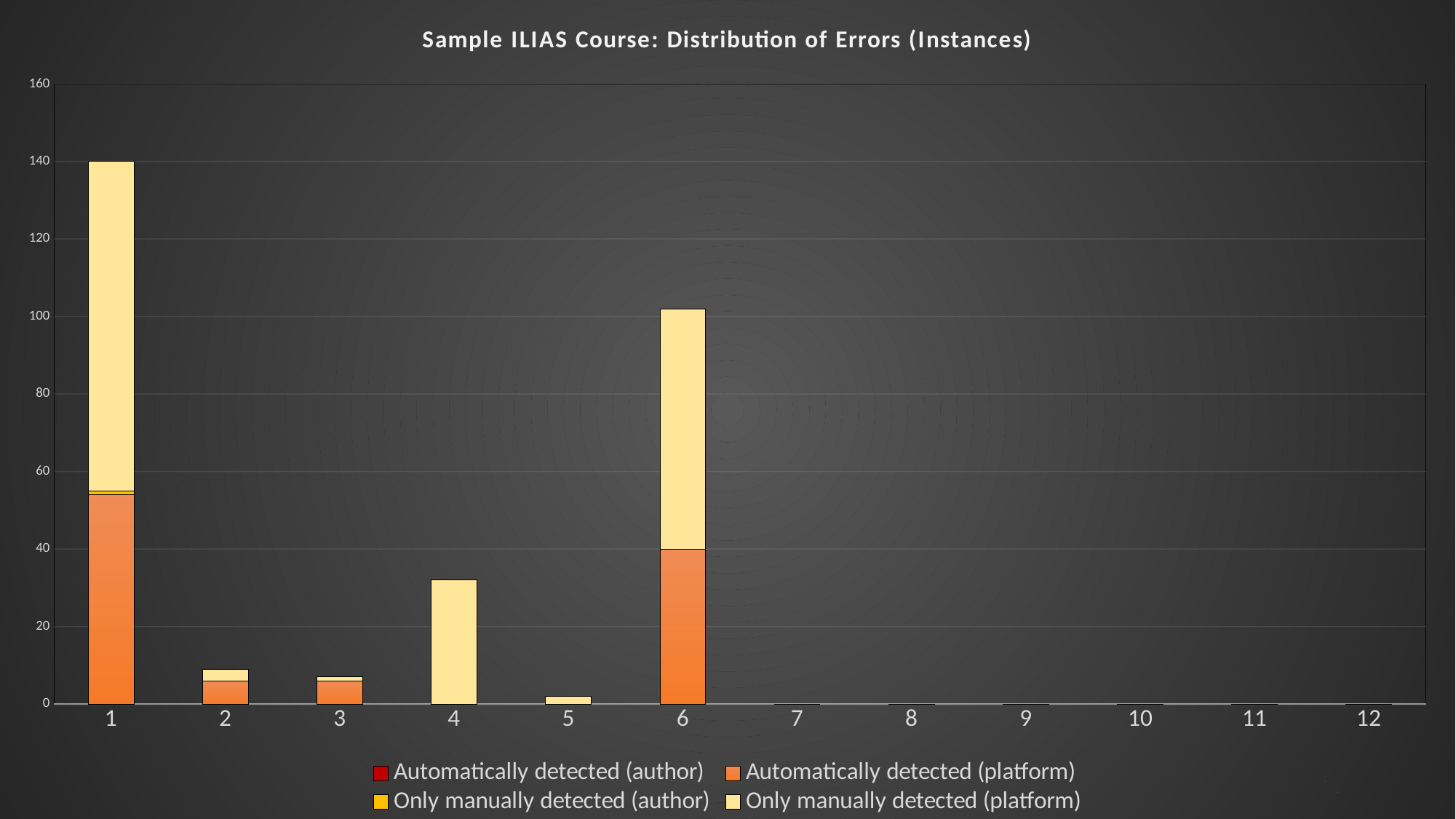
What is the title of the chart? Sample ILIAS Course: Distribution of Errors (Instances) How many categories are shown on the x axis? 12 What kind of chart is shown on the slide? Stacked bar chart What is the total height of the stacked bar for category 1? 140 Which has a larger total, category 4 or category 6? 6 How many series does the legend list? 4 Is the total for category 4 greater or less than 40? less Is the total for category 6 greater or less than 120? less Which category has the highest total number of error instances? 1 Which legend entry is shown in the lightest yellow colour? Only manually detected (platform) Among categories 1 to 6, which has the lowest total? 5